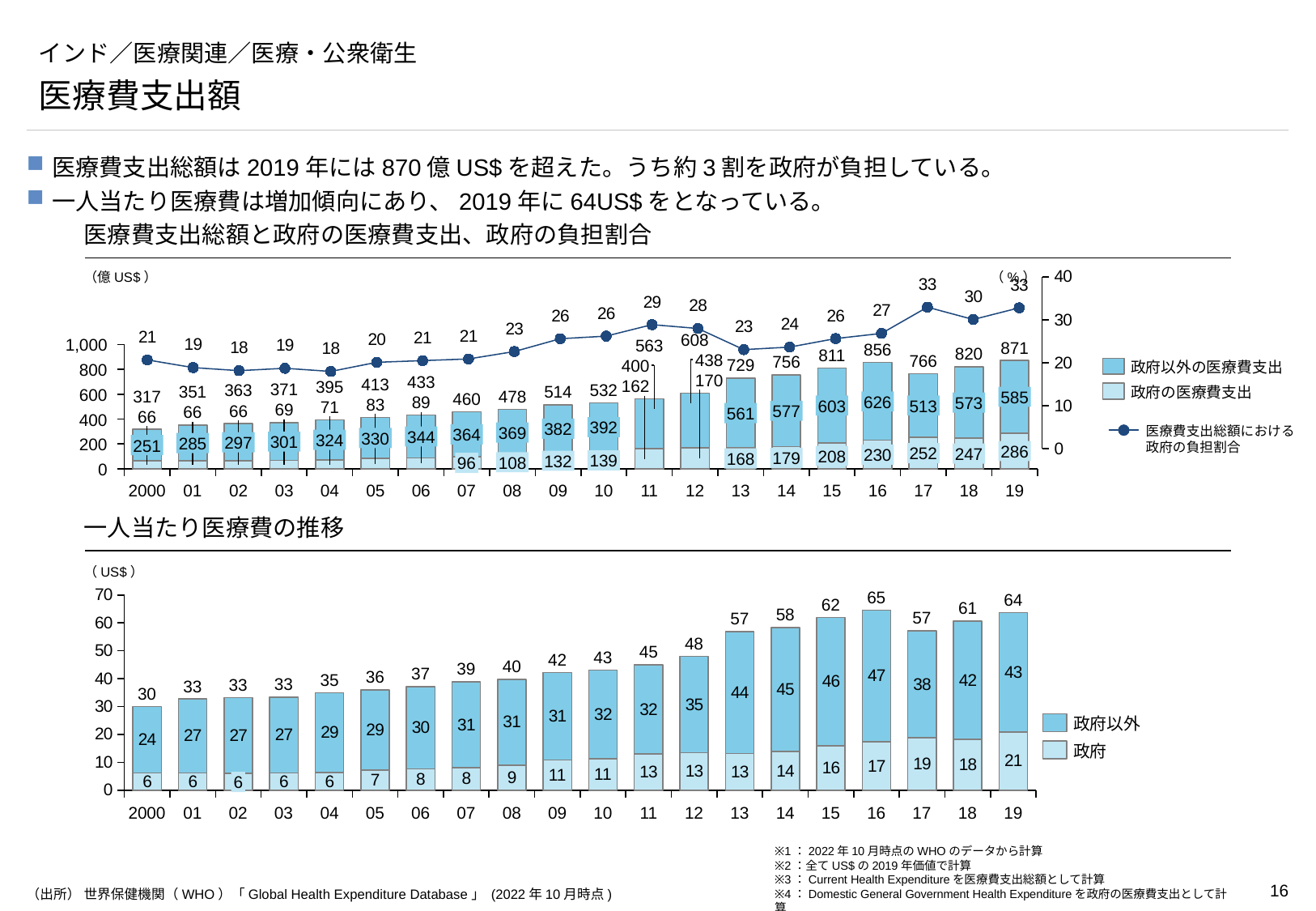
In the chart '医療費支出総額と政府の医療費支出、政府の負担割合', what is the value of 政府の医療費支出 for 2016? 230 In the chart '医療費支出総額と政府の医療費支出、政府の負担割合', what is the difference between the total for 2019 and the total for 2018? 51 In the chart '一人当たり医療費の推移', what is the per-capita total for 2019? 64 In the chart '医療費支出総額と政府の医療費支出、政府の負担割合', what is the government share (政府の負担割合) for 2011? 29 In the chart '一人当たり医療費の推移', what is the 政府 value for 2017? 19 In the chart '医療費支出総額と政府の医療費支出、政府の負担割合', which year has the lowest total health expenditure? 2000 What kind of chart is '一人当たり医療費の推移'? Stacked bar chart In the chart '医療費支出総額と政府の医療費支出、政府の負担割合', what is the total health expenditure (bar total) for 2019? 871 In the chart '一人当たり医療費の推移', which year has the highest per-capita total? 2016 In the chart '一人当たり医療費の推移', how many years are shown on the x axis? 20 In the chart '一人当たり医療費の推移', is the 政府以外 value larger for 2013 or for 2017? 2013 In the chart '医療費支出総額と政府の医療費支出、政府の負担割合', how many series does the legend list? 3